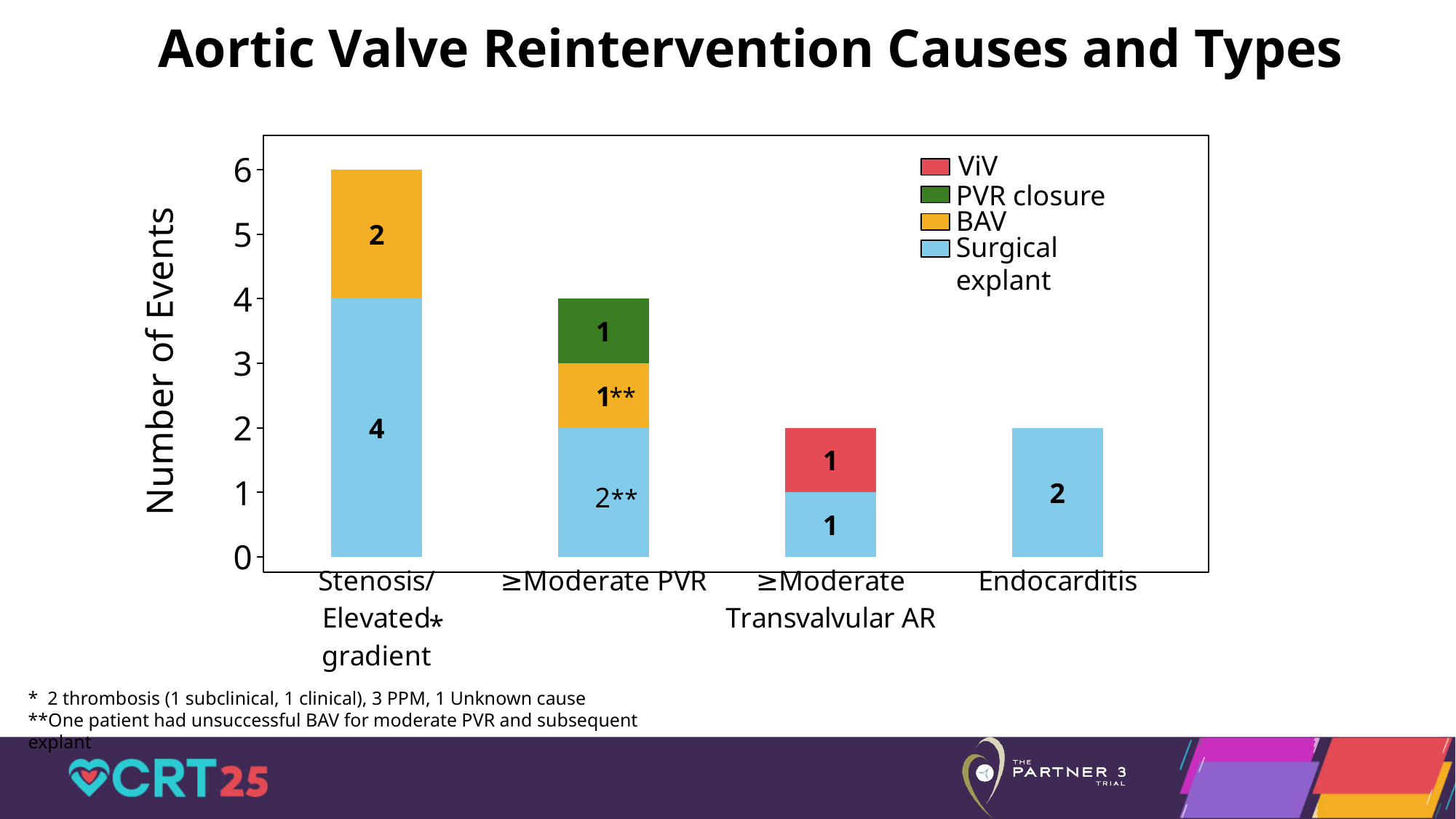
How many series does the legend list? 4 What is the number of Surgical explant events for Endocarditis? 2 What is the total number of events for the Stenosis/Elevated gradient bar? 6 What is the number of PVR closure events for ≥Moderate PVR? 1 What is the difference between the total events for Stenosis/Elevated gradient and Endocarditis? 4 Which category has the highest total number of events? Stenosis/Elevated gradient What is the number of BAV events for Stenosis/Elevated gradient? 2 What is the number of ViV events for ≥Moderate Transvalvular AR? 1 What is the number of Surgical explant events for Stenosis/Elevated gradient? 4 How many categories are shown on the x axis? 4 What is the total number of events for the ≥Moderate PVR bar? 4 What kind of chart is shown on the slide? Stacked bar chart